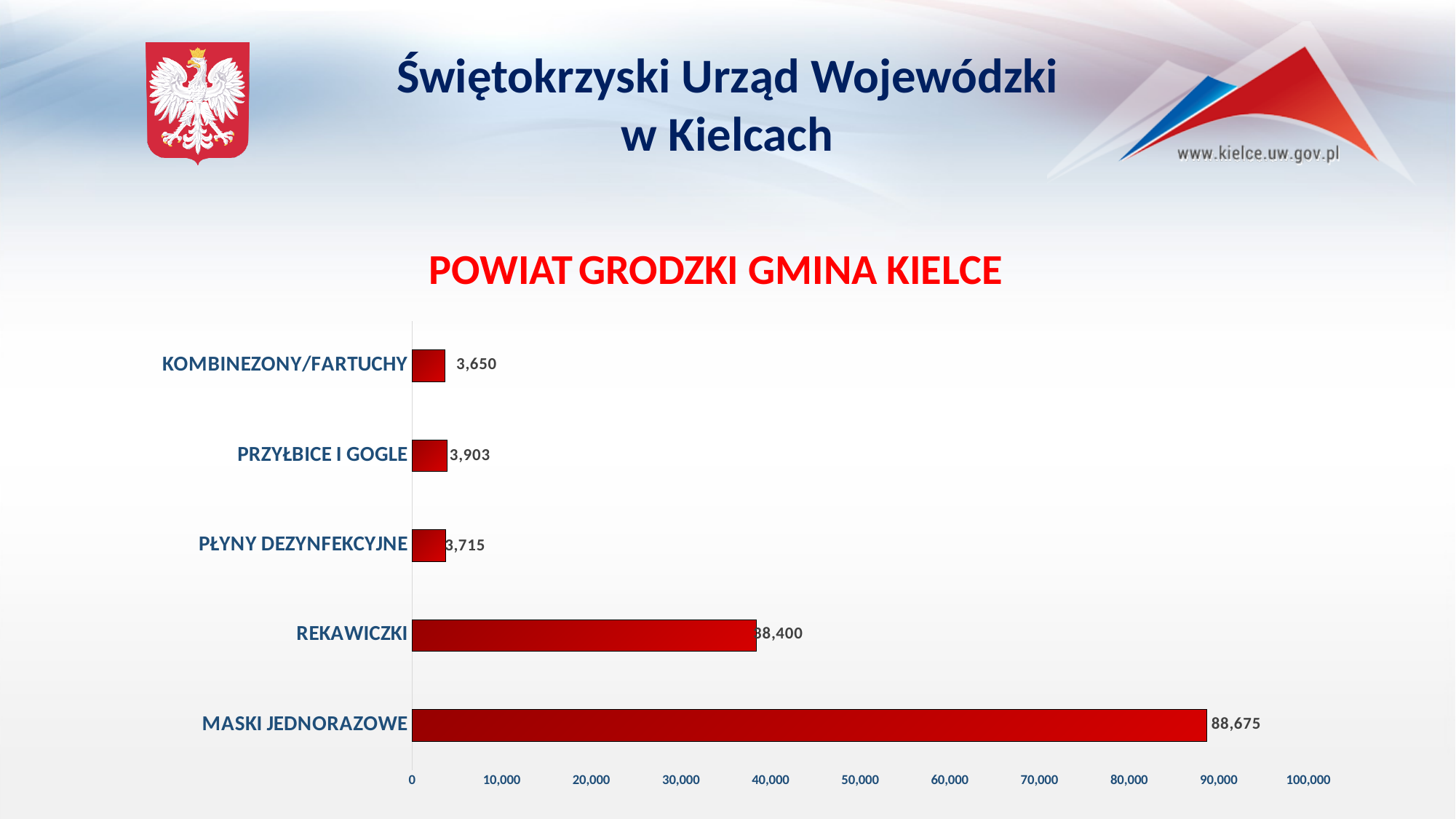
What is the value for RĘKAWICZKI? 38,400 Which category has the lowest value? KOMBINEZONY/FARTUCHY Which is larger, the value for RĘKAWICZKI or the value for PŁYNY DEZYNFEKCYJNE? RĘKAWICZKI What is the difference between the values for PRZYŁBICE I GOGLE and KOMBINEZONY/FARTUCHY? 253 What is the value for MASKI JEDNORAZOWE? 88,675 Is the value for RĘKAWICZKI greater or less than 30,000? greater What kind of chart is shown on the slide? bar chart Which category has the highest value? MASKI JEDNORAZOWE What is the difference between the values for MASKI JEDNORAZOWE and RĘKAWICZKI? 50,275 What is the value for KOMBINEZONY/FARTUCHY? 3,650 How many categories are shown in the chart? 5 What is the value for PRZYŁBICE I GOGLE? 3,903